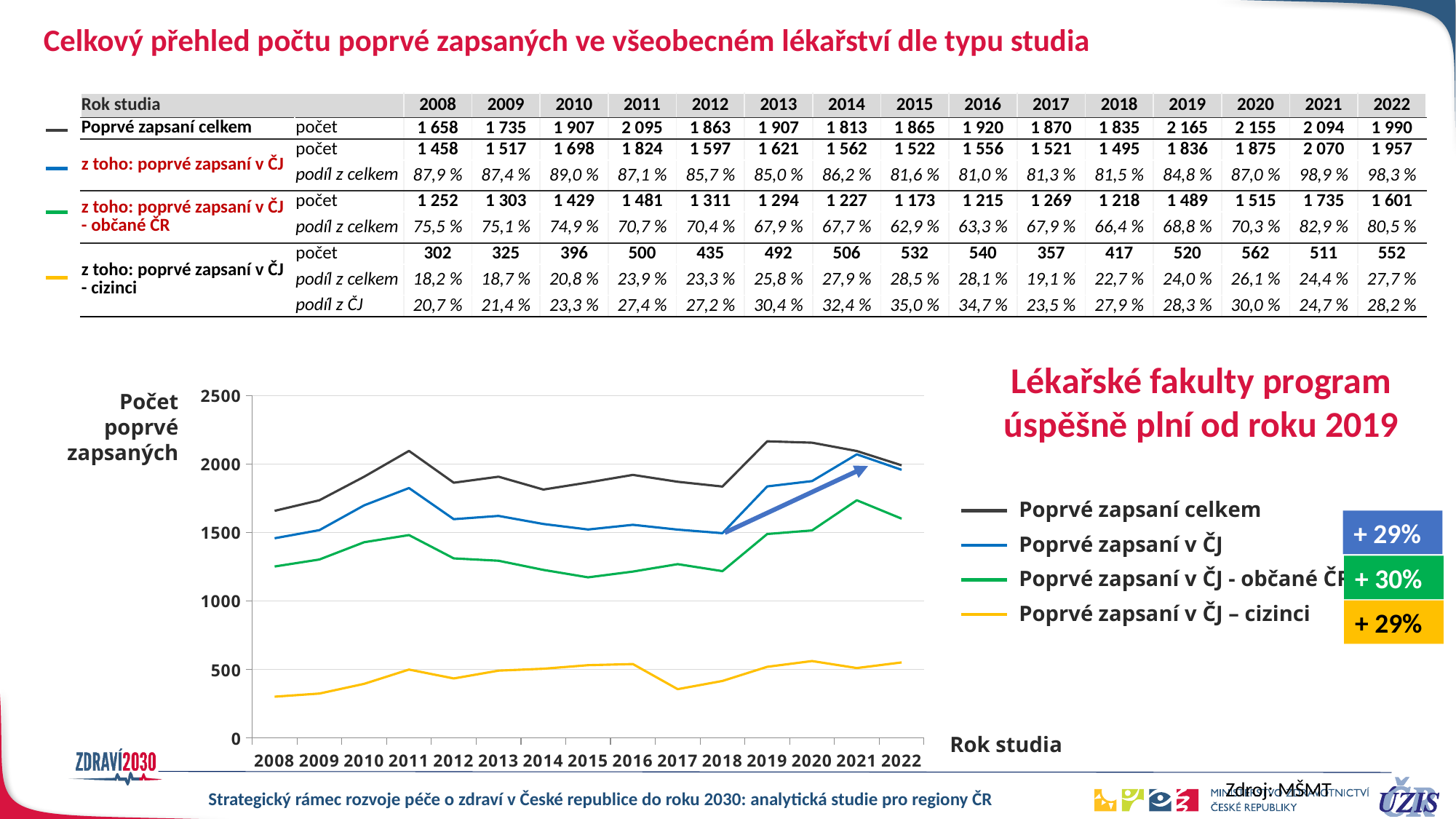
What is the difference between Poprvé zapsaní celkem in 2011 and in 2008? 437 Is the value for Poprvé zapsaní v ČJ - občané ČR in 2021 greater or less than 1500? greater What kind of chart is shown on the slide? line chart What is the title of the x axis of the chart? Rok studia What is the value of Poprvé zapsaní celkem in 2019? 2 165 In which year is Poprvé zapsaní v ČJ - cizinci lowest? 2008 How many years are plotted along the x axis of the chart? 15 What is the value of Poprvé zapsaní v ČJ - cizinci in 2014? 506 Does the Poprvé zapsaní v ČJ - cizinci line rise or fall from 2008 to 2011? rise How many series does the chart legend list? 4 Which is larger for Poprvé zapsaní v ČJ - cizinci: the value in 2016 or in 2017? 2016 In which year is Poprvé zapsaní celkem highest? 2019